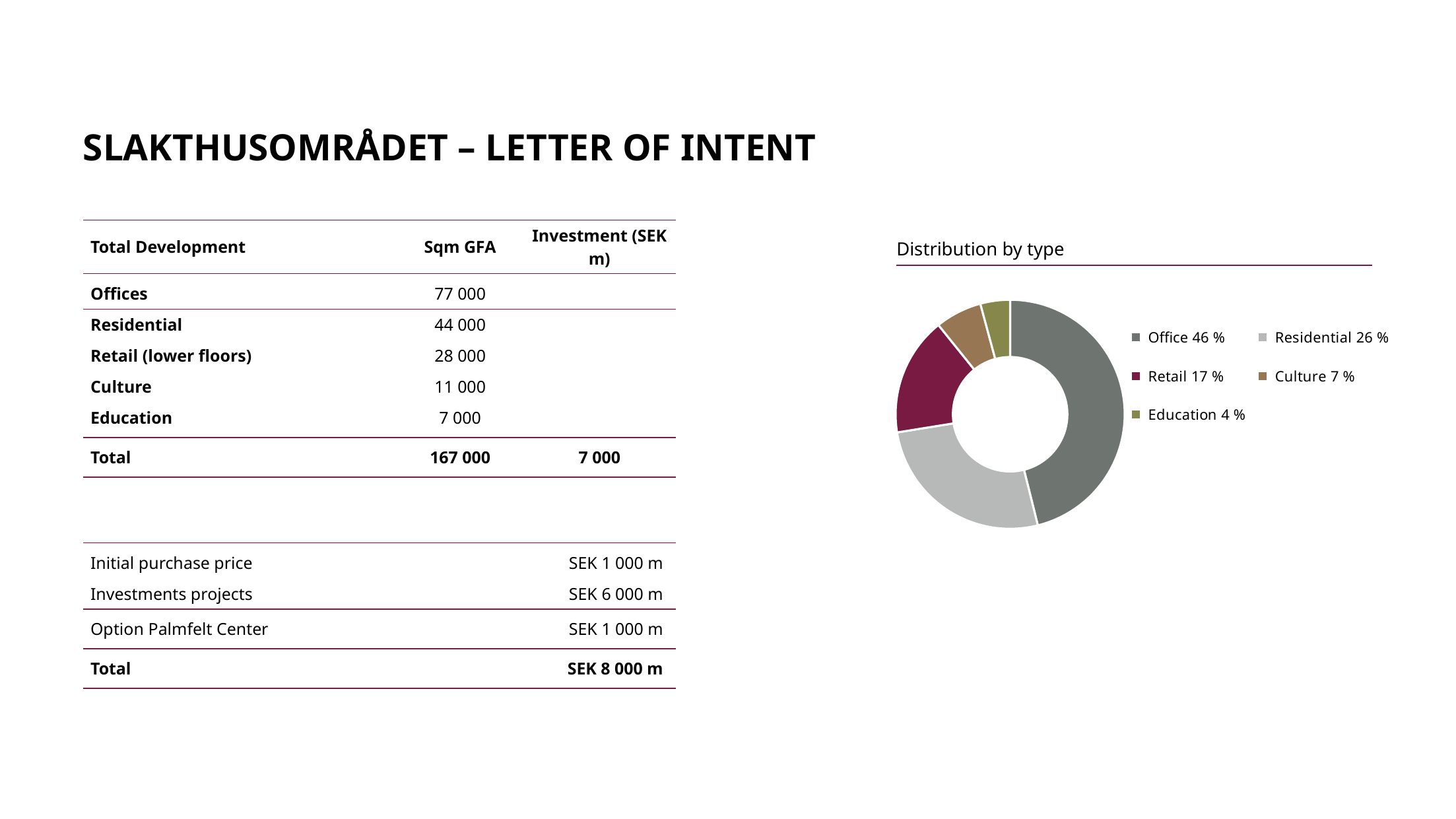
What is the title of the chart on the slide? Distribution by type Which category has the smallest share in the 'Distribution by type' chart? Education How many categories does the 'Distribution by type' chart show? 5 In the 'Distribution by type' chart, what is the difference in percentage points between Office and Residential? 20 What share does Education have in the 'Distribution by type' chart? 4 % What share does Residential have in the 'Distribution by type' chart? 26 % What share does Office have in the 'Distribution by type' chart? 46 % In the 'Distribution by type' chart, which is larger, Retail or Culture? Retail What kind of chart is 'Distribution by type'? Doughnut chart Which category has the largest share in the 'Distribution by type' chart? Office